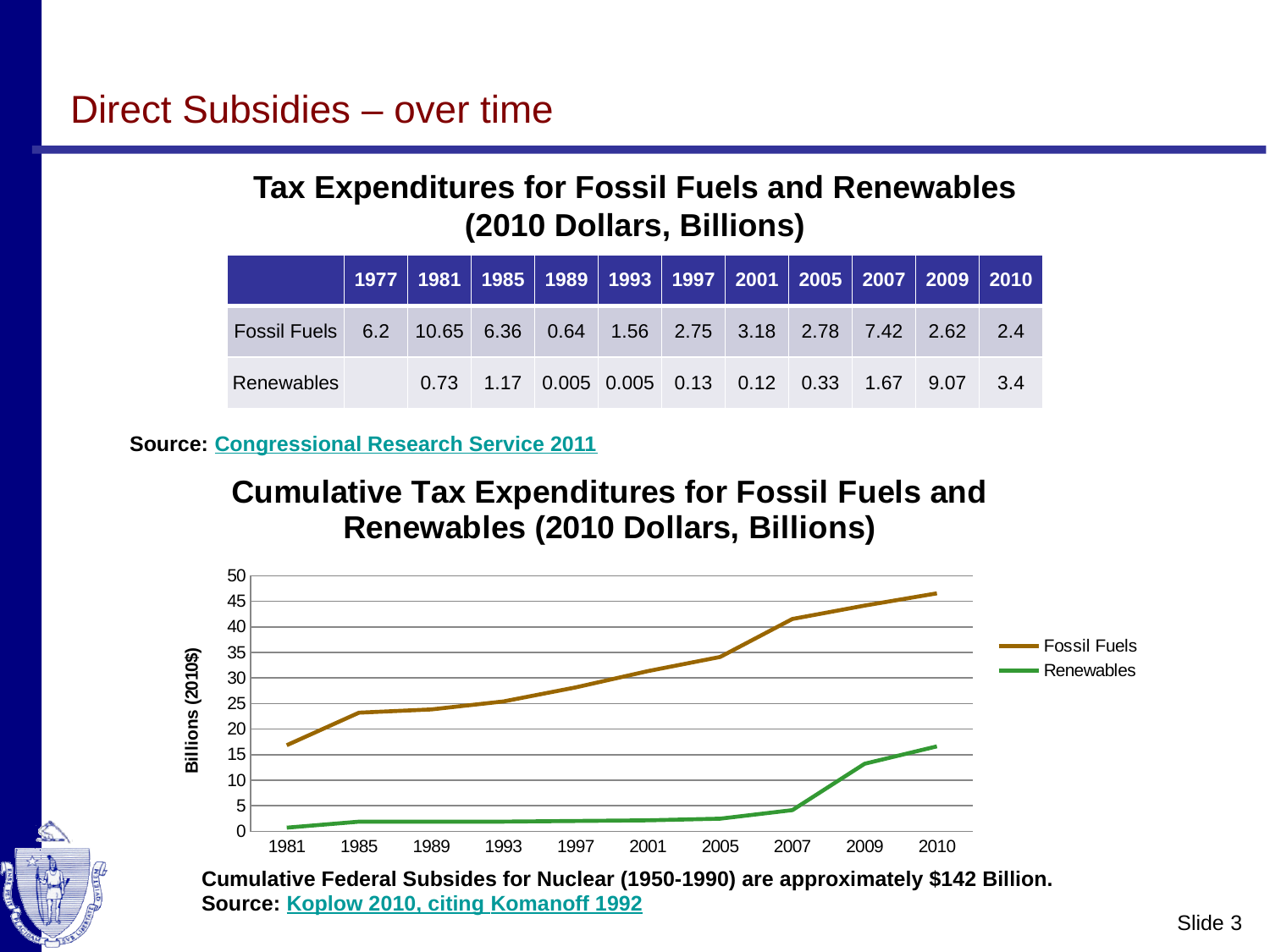
How many years are shown on the x axis of the cumulative tax expenditures chart? 10 In the cumulative tax expenditures chart, do the Renewables values rise or fall from 1981 to 2010? rise In the cumulative tax expenditures chart, which series has the larger value in 2010, Fossil Fuels or Renewables? Fossil Fuels How many series does the legend of the cumulative tax expenditures chart list? 2 What kind of chart is the 'Cumulative Tax Expenditures for Fossil Fuels and Renewables' chart? line chart In the cumulative tax expenditures chart, is the Renewables value for 2009 greater or less than 10? greater What is the y-axis label of the cumulative tax expenditures chart? Billions (2010$) In the cumulative tax expenditures chart, is the Renewables value for 2005 greater or less than 5? less In the cumulative tax expenditures chart, in which year does the Fossil Fuels line reach its highest value? 2010 In the cumulative tax expenditures chart, is the Fossil Fuels value for 1981 greater or less than 20? less